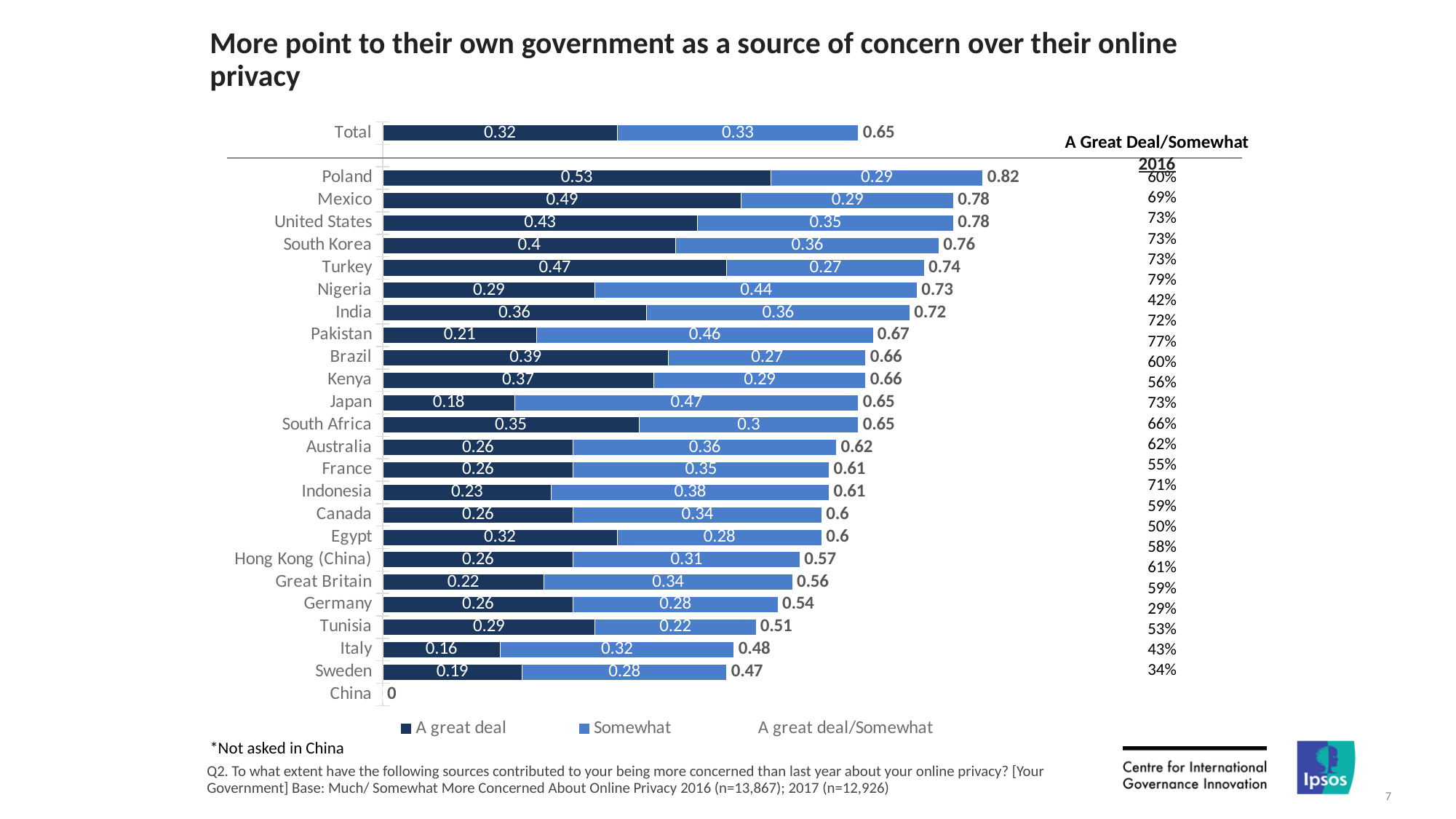
What kind of chart is shown on the slide? Stacked bar chart Among the countries with plotted bars, which has the lowest combined 'A great deal/Somewhat' value? Sweden How many countries are listed on the y axis, excluding the Total row? 24 Which is larger, the 'A great deal' value for Turkey or for Mexico? Mexico What is the total of the stacked bar for Japan? 0.65 What is the 'A great deal' value for Poland? 0.53 Which country has the highest 'Somewhat' value? Japan What is the combined 'A great deal/Somewhat' value shown for Total? 0.65 How many series does the legend list? 3 What is the 'Somewhat' value for Nigeria? 0.44 What is the difference between the combined values for Poland and Sweden? 0.35 Which country has the highest 'A great deal' value? Poland